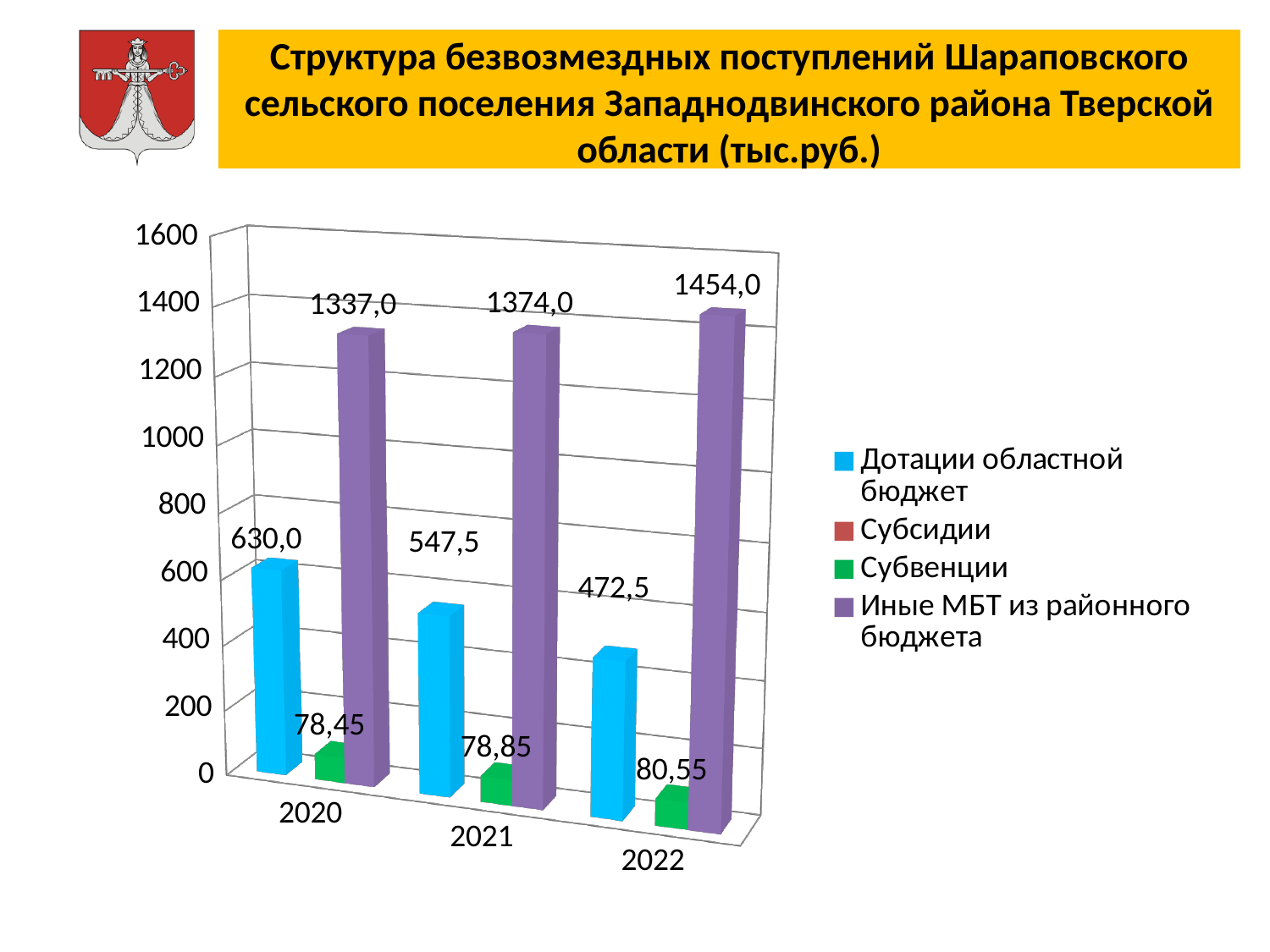
Do the values of Дотации областной бюджет rise or fall from 2020 to 2022? Fall What is the difference between Дотации областной бюджет in 2020 and in 2021? 82,5 Which is larger in 2021: Дотации областной бюджет or Иные МБТ из районного бюджета? Иные МБТ из районного бюджета What is the difference between Иные МБТ из районного бюджета in 2022 and in 2020? 117,0 What kind of chart is shown on the slide? Bar chart What is the value of Субвенции for 2021? 78,85 What is the value of Дотации областной бюджет for 2020? 630,0 In which year is Иные МБТ из районного бюджета the highest? 2022 What is the value of Иные МБТ из районного бюджета for 2022? 1454,0 How many series does the legend list? 4 How many years are shown on the x axis? 3 In which year is Дотации областной бюджет the lowest? 2022